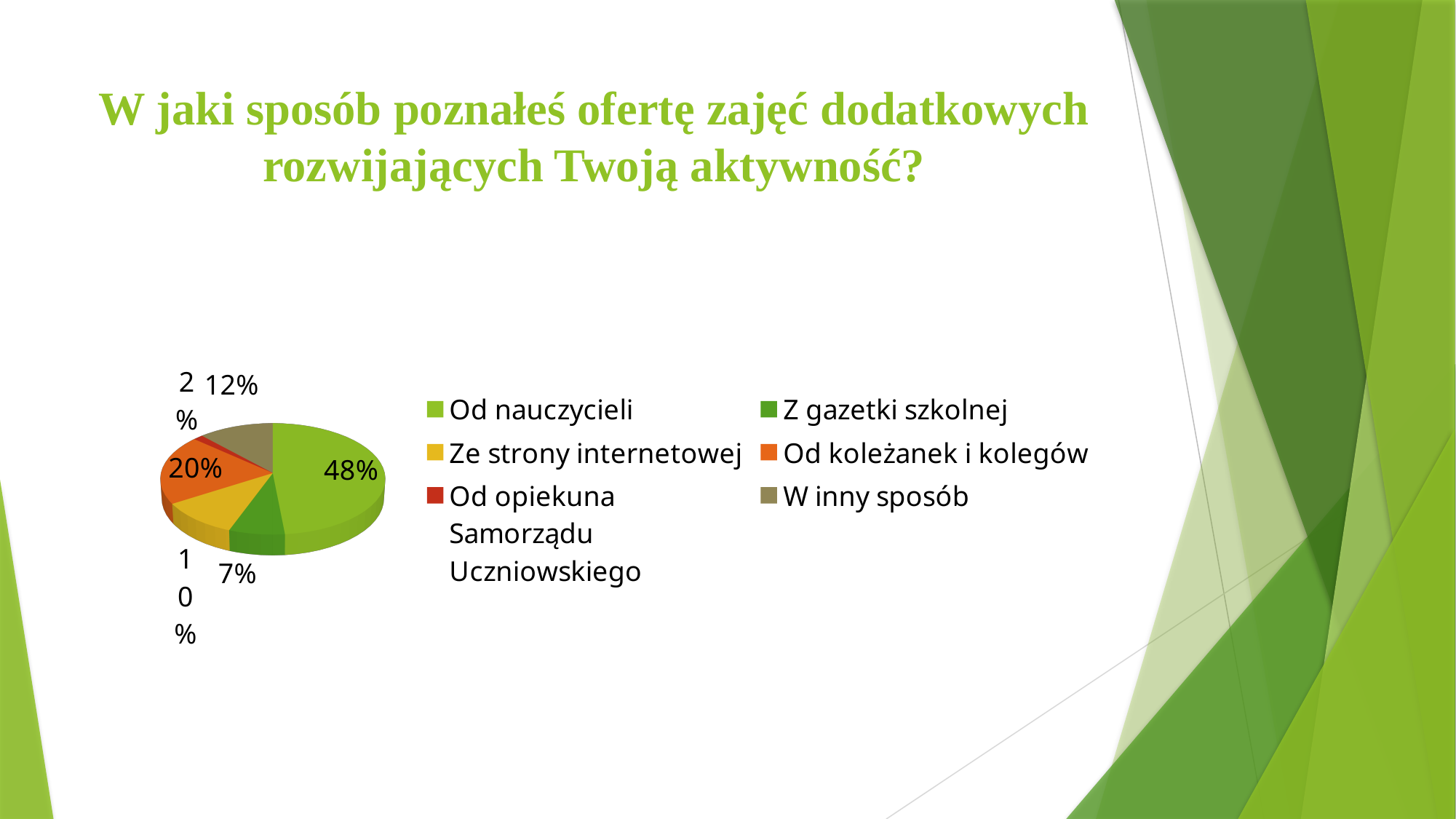
What percentage is shown for "Z gazetki szkolnej"? 7% Which category has the smallest share of the pie? Od opiekuna Samorządu Uczniowskiego What is the difference in percentage points between "Od nauczycieli" and "Od koleżanek i kolegów"? 28 What percentage is shown for "Od koleżanek i kolegów"? 20% What percentage is shown for "Ze strony internetowej"? 10% Which is larger: the share for "W inny sposób" or the share for "Ze strony internetowej"? W inny sposób Which category has the largest share of the pie? Od nauczycieli What percentage of respondents learned about the offer "Od nauczycieli"? 48% What colour is the slice for "Od koleżanek i kolegów"? orange What percentage is shown for "W inny sposób"? 12% How many categories does the legend list? 6 What kind of chart is shown on the slide? pie chart